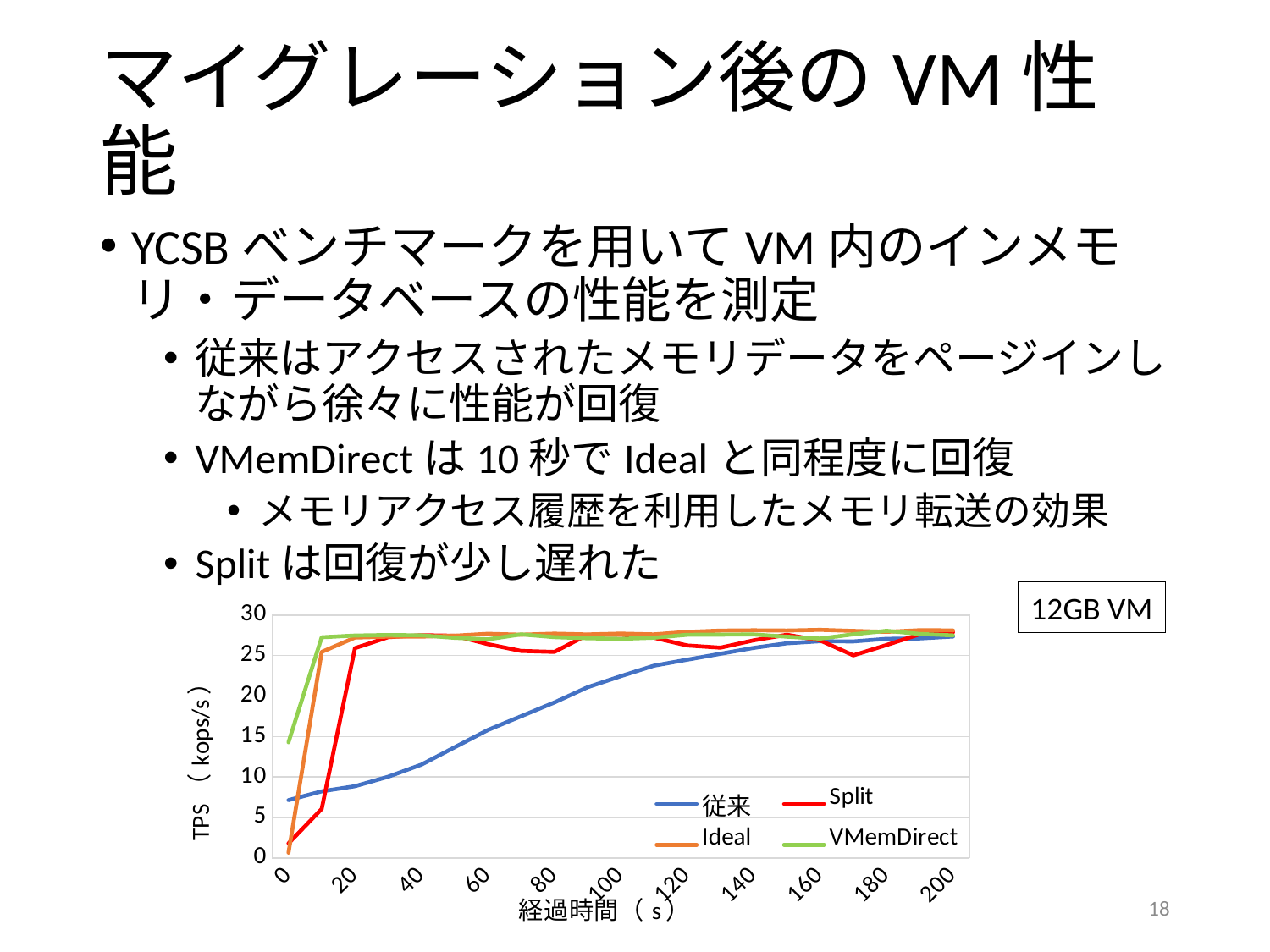
Is the value for 従来 at 0 s greater or less than 10? less Which series has the lowest value at 60 s? 従来 Is the value for Split at 0 s greater or less than 5? less How many series does the chart's legend list? 4 What kind of chart is shown on the slide? line chart Is the value for VMemDirect at 40 s greater or less than 25? greater At 0 s, which series has the larger value, VMemDirect or Split? VMemDirect What are the series names listed in the chart's legend? 従来, Split, Ideal, VMemDirect At 40 s, which series has the larger value, VMemDirect or 従来? VMemDirect What is the label of the chart's y axis? TPS (kops/s)